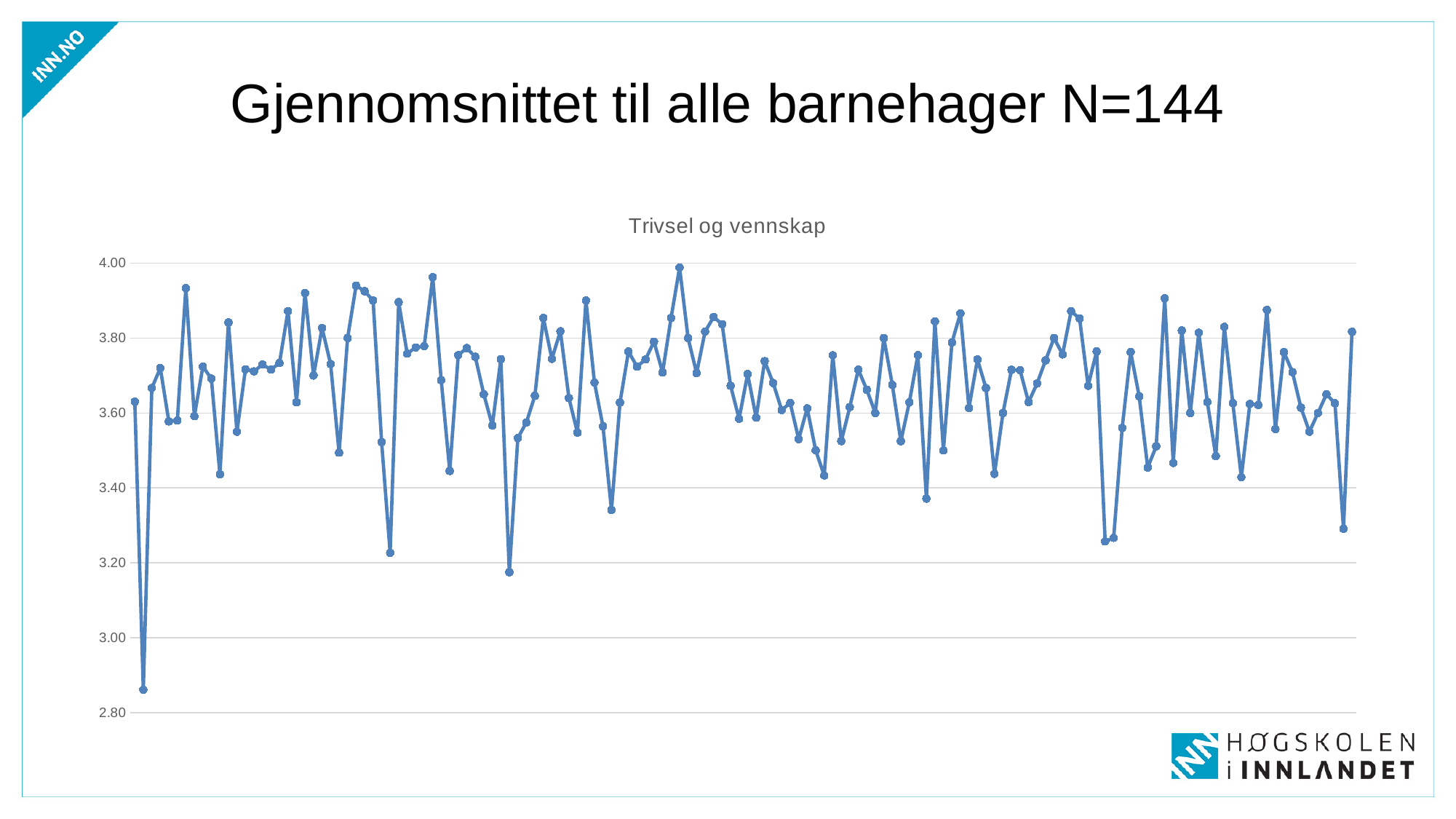
Is the last point on the line greater or less than 3.60? greater Is the second point on the line greater or less than 3.20? less Is the highest point on the line greater or less than 3.80? greater What is the title of the chart? Trivsel og vennskap What is the highest value shown on the chart's vertical axis? 4.00 Do the values show a clear rising or falling trend along the x axis? neither, they fluctuate How many lines are plotted on the chart? 1 What kind of chart is shown on the slide? line chart